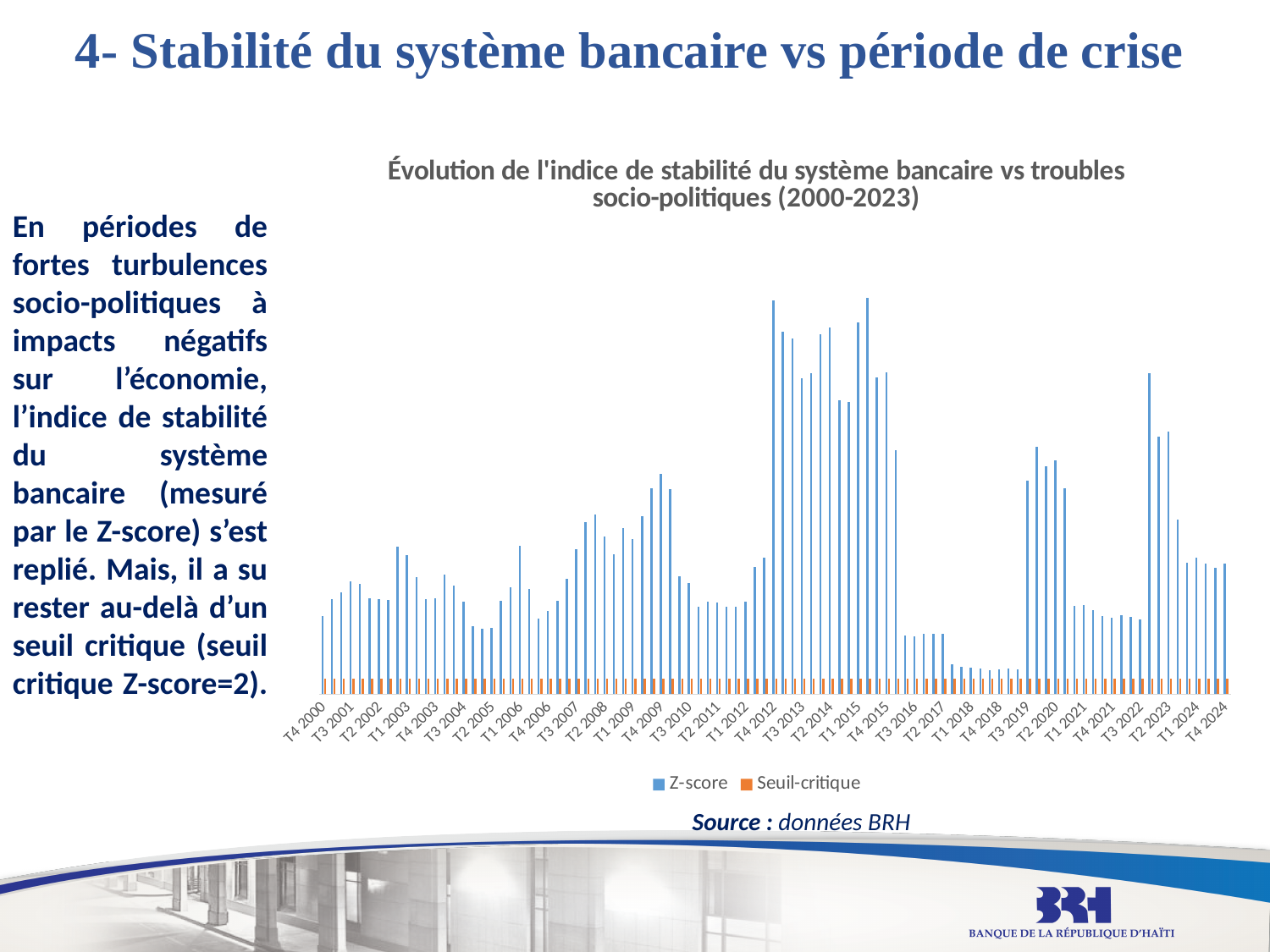
Which is larger, the Z-score at T3 2019 or the Z-score at T1 2018? T3 2019 Which series has the higher values across the chart, Z-score or Seuil-critique? Z-score Between T1 2018 and T3 2019, do the Z-score values generally rise or fall? rise Which is larger, the Z-score at T2 2023 or the Z-score at T1 2018? T2 2023 Between T4 2015 and T2 2017, do the Z-score values generally rise or fall? fall How many series does the legend list? 2 What is the title of the chart? Évolution de l'indice de stabilité du système bancaire vs troubles socio-politiques (2000-2023) Which series is shown in orange in the legend? Seuil-critique What type of chart is shown on the slide? bar chart